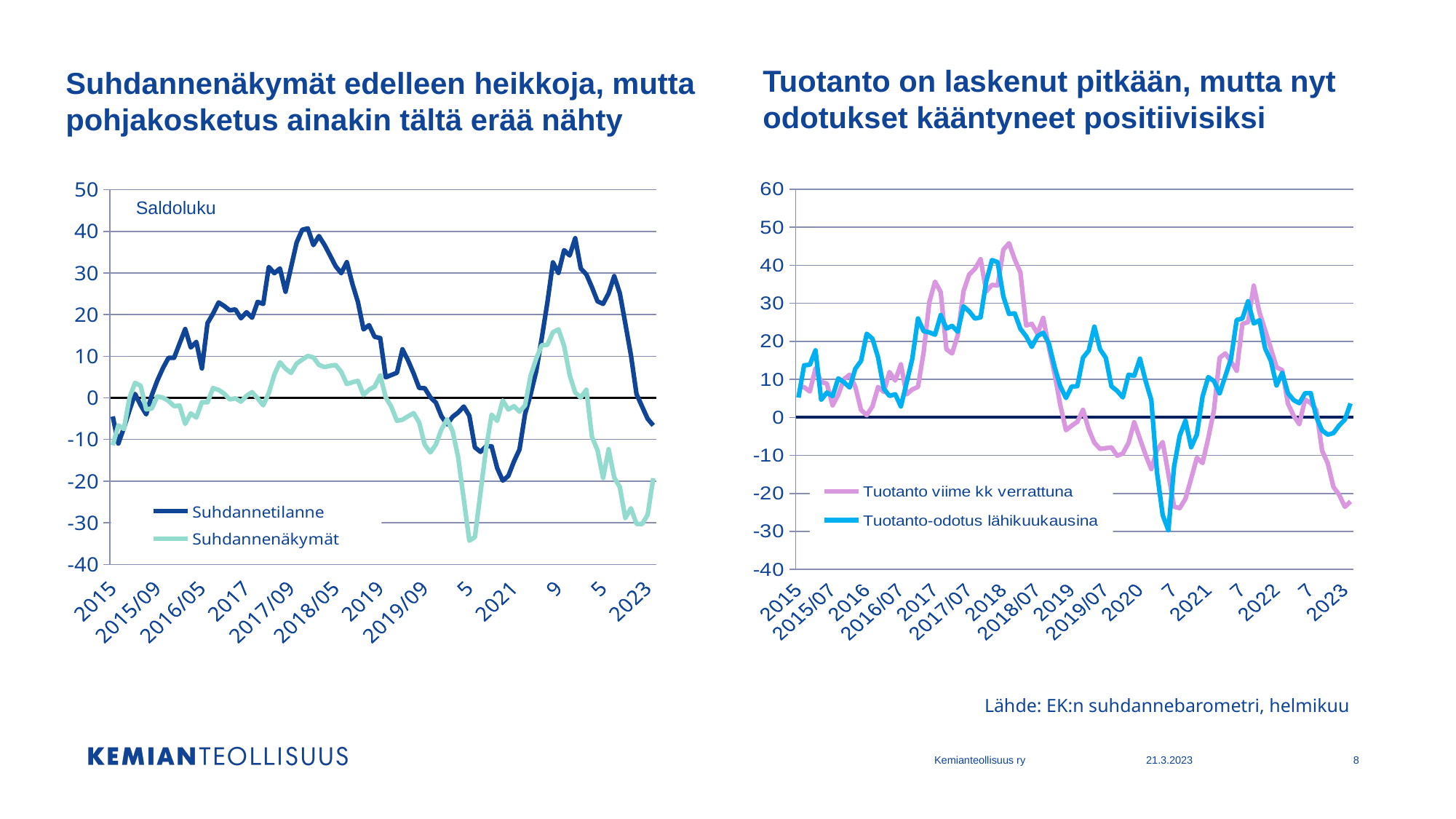
How many series does the legend of the right chart list? 2 What kind of chart is the right chart titled 'Tuotanto on laskenut pitkään, mutta nyt odotukset kääntyneet positiivisiksi'? Line chart In the right chart, is the peak value of Tuotanto viime kk verrattuna in 2018 greater or less than 40? greater In the left chart, does Suhdannetilanne rise or fall from 2022 to 2023? Fall How many series does the legend of the left chart list? 2 In the right chart, which series is drawn in pink? Tuotanto viime kk verrattuna In the left chart, is the lowest value of Suhdannenäkymät (around 2020) greater or less than -30? less In the right chart, is the value of Tuotanto-odotus lähikuukausina at the end of the series in 2023 greater or less than 0? greater In the right chart, at the end of the series in 2023, which series has the higher value: Tuotanto viime kk verrattuna or Tuotanto-odotus lähikuukausina? Tuotanto-odotus lähikuukausina In the left chart, which series is drawn in dark blue? Suhdannetilanne What kind of chart is the left chart titled 'Suhdannenäkymät edelleen heikkoja, mutta pohjakosketus ainakin tältä erää nähty'? Line chart